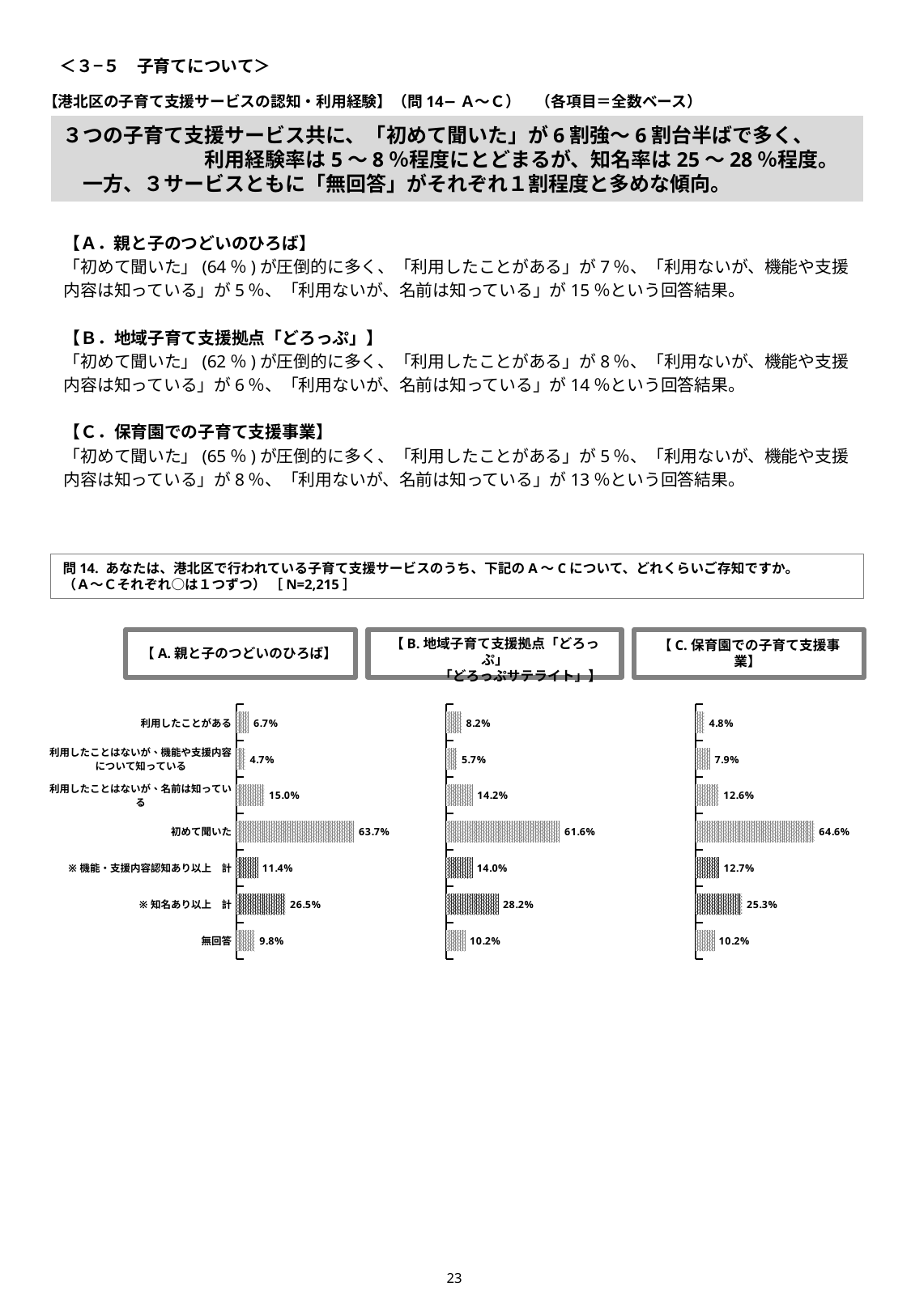
Which chart has the higher value for ※知名あり以上 計: 【A. 親と子のつどいのひろば】 or 【B. 地域子育て支援拠点「どろっぷ」「どろっぷサテライト」】? 【B. 地域子育て支援拠点「どろっぷ」「どろっぷサテライト」】 How many categories are shown in the chart 【A. 親と子のつどいのひろば】? 7 In the chart 【B. 地域子育て支援拠点「どろっぷ」「どろっぷサテライト」】, what is the value for 利用したことがある? 8.2% In the chart 【A. 親と子のつどいのひろば】, what is the value for ※機能・支援内容認知あり以上 計? 11.4% In the chart 【C. 保育園での子育て支援事業】, which category has the highest value? 初めて聞いた In the chart 【C. 保育園での子育て支援事業】, which is larger: 利用したことがある or 利用したことはないが、機能や支援内容について知っている? 利用したことはないが、機能や支援内容について知っている How many charts are shown on the slide? 3 In the chart 【B. 地域子育て支援拠点「どろっぷ」「どろっぷサテライト」】, what is the difference between 初めて聞いた and 利用したことはないが、名前は知っている? 47.4% In the chart 【C. 保育園での子育て支援事業】, what is the value for 無回答? 10.2% What kind of chart is 【B. 地域子育て支援拠点「どろっぷ」「どろっぷサテライト」】? Bar chart In the chart 【A. 親と子のつどいのひろば】, which category has the lowest value? 利用したことはないが、機能や支援内容について知っている In the chart 【A. 親と子のつどいのひろば】, what is the value for 初めて聞いた? 63.7%